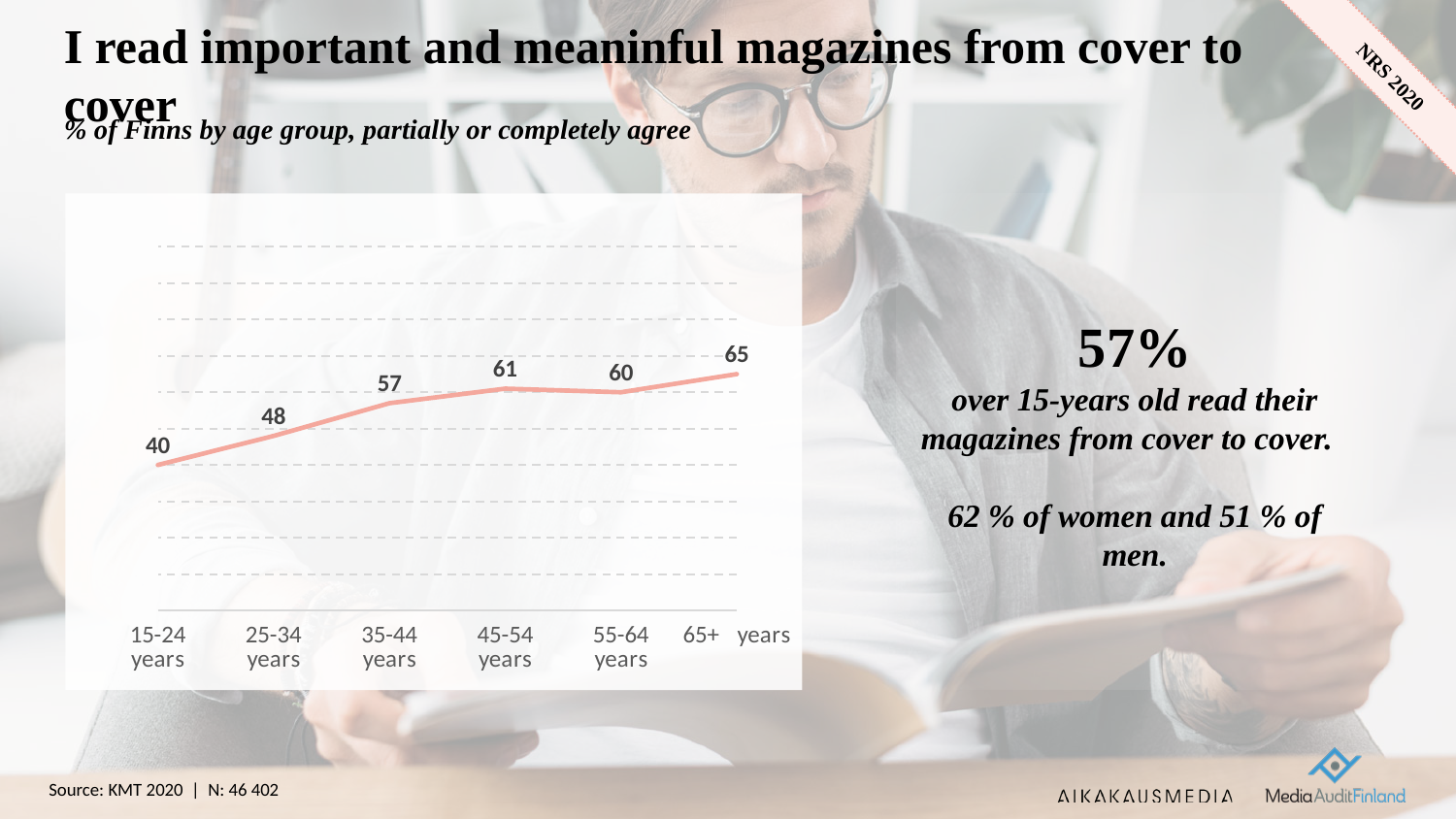
What kind of chart is shown on the slide? Line chart What is the value for the 65+ years age group? 65 Which age group has the highest value? 65+ years What is the value for the 15-24 years age group? 40 Do the values generally rise or fall from the youngest to the oldest age group? Rise What is the difference between the values for 45-54 years and 25-34 years? 13 Which is larger, the value for 45-54 years or the value for 55-64 years? 45-54 years What is the difference between the values for 65+ years and 15-24 years? 25 What is the value for the 35-44 years age group? 57 How many age groups are plotted on the chart? 6 What is the subtitle of the chart describing what the values represent? % of Finns by age group, partially or completely agree Which age group has the lowest value? 15-24 years